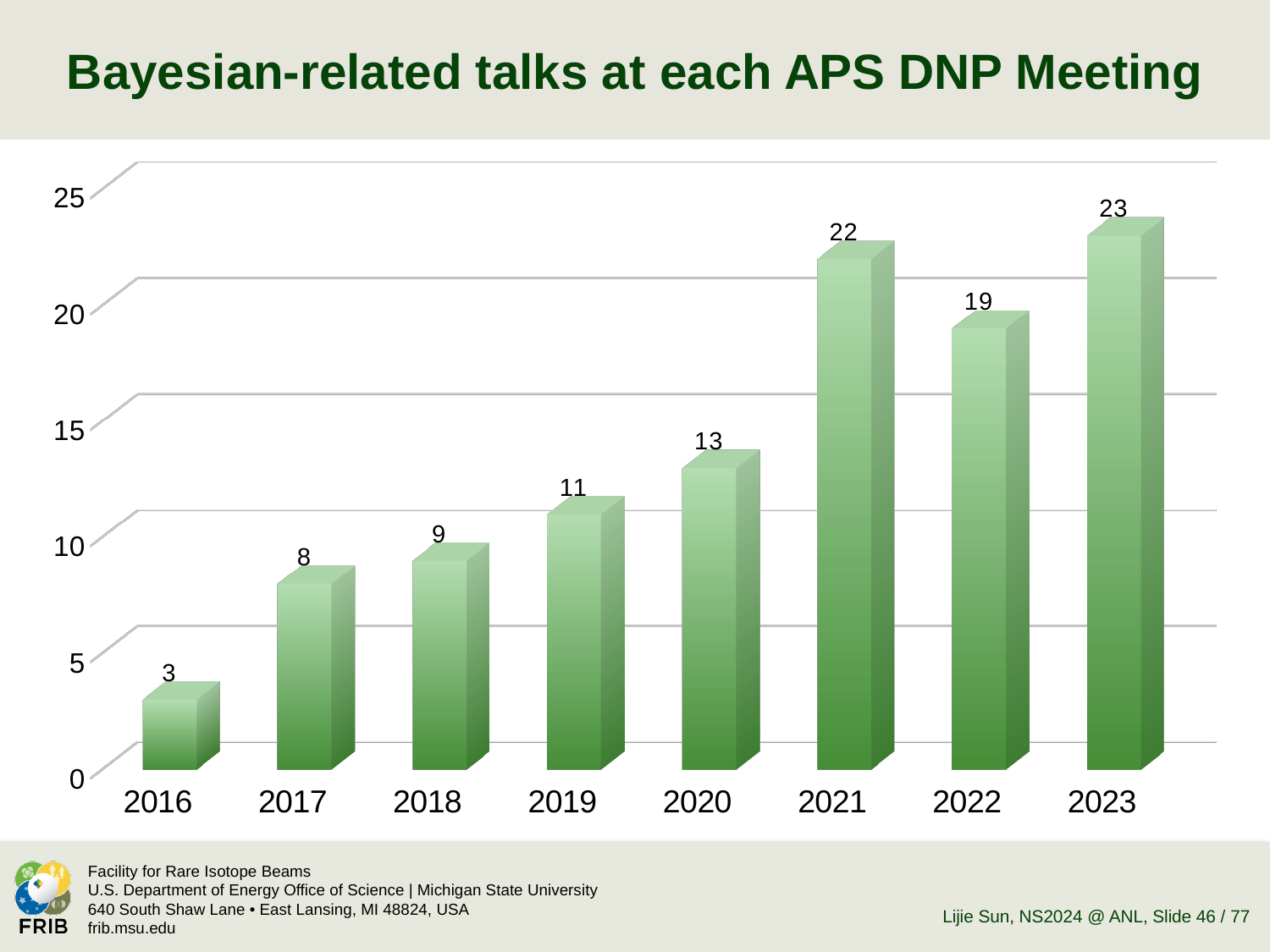
What is the value shown for 2022? 19 Which year has the highest number of Bayesian-related talks? 2023 Is the value for 2021 greater or less than 20? greater How many Bayesian-related talks were there at the 2016 APS DNP Meeting? 3 What kind of chart is shown on the slide? bar chart Which year has the lowest number of Bayesian-related talks? 2016 What is the title of the chart? Bayesian-related talks at each APS DNP Meeting What is the difference between the values for 2021 and 2022? 3 How many years are shown on the x axis? 8 What is the value shown for 2020? 13 Which is larger, the value for 2019 or the value for 2018? 2019 What is the difference between the values for 2023 and 2016? 20